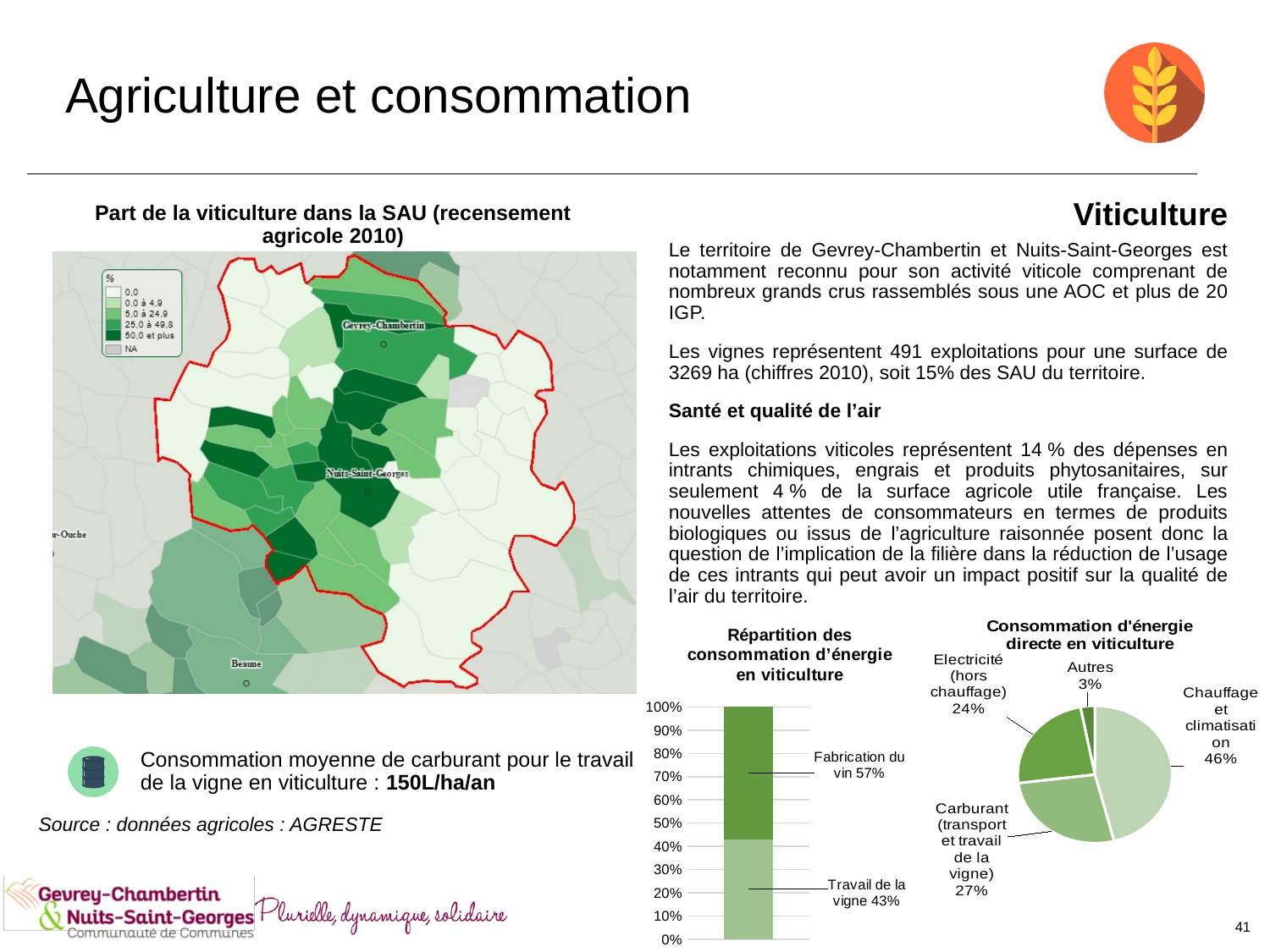
In the stacked bar chart 'Répartition des consommation d'énergie en viticulture', what percentage is Fabrication du vin? 57% In the pie chart 'Consommation d'énergie directe en viticulture', which category has the smallest share? Autres In the pie chart 'Consommation d'énergie directe en viticulture', what share is Electricité (hors chauffage)? 24% In the pie chart 'Consommation d'énergie directe en viticulture', what share is Carburant (transport et travail de la vigne)? 27% In the pie chart 'Consommation d'énergie directe en viticulture', what share is Chauffage et climatisation? 46% In the stacked bar chart 'Répartition des consommation d'énergie en viticulture', what percentage is Travail de la vigne? 43% In the pie chart 'Consommation d'énergie directe en viticulture', how many slices are there? 4 In the stacked bar chart 'Répartition des consommation d'énergie en viticulture', which segment is larger, Fabrication du vin or Travail de la vigne? Fabrication du vin In the pie chart 'Consommation d'énergie directe en viticulture', which category has the largest share? Chauffage et climatisation In the stacked bar chart 'Répartition des consommation d'énergie en viticulture', what is the total of the two segments? 100% What type of chart is 'Consommation d'énergie directe en viticulture'? Pie chart In the pie chart 'Consommation d'énergie directe en viticulture', what is the difference between the Carburant share and the Electricité (hors chauffage) share? 3%